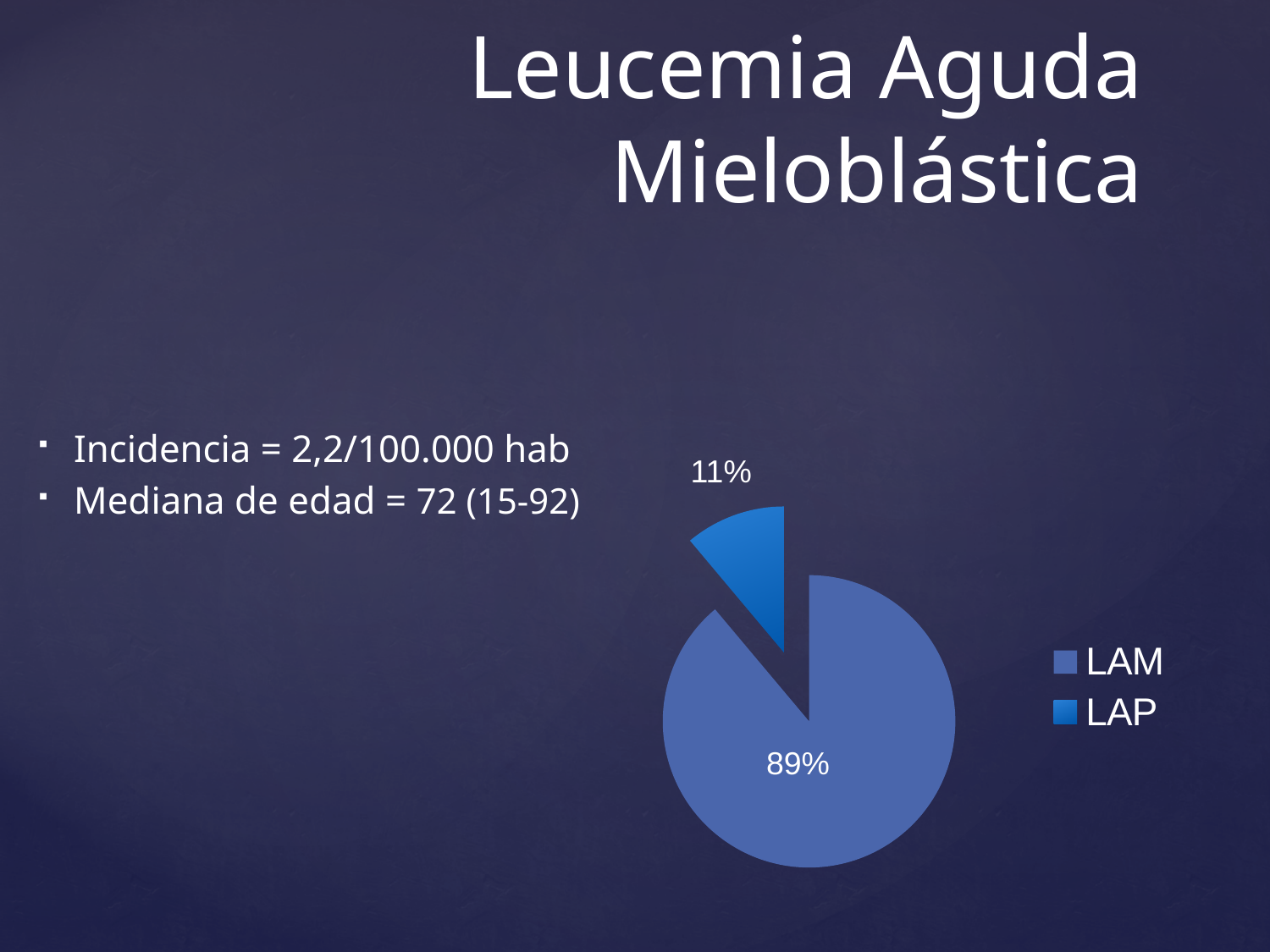
What is the difference in percentage points between the LAM and LAP slices? 78 Which is larger, the share for LAM or the share for LAP? LAM What are the two legend entries of the pie chart? LAM and LAP How many slices does the pie chart have? 2 Which category has the largest slice of the pie? LAM What kind of chart is shown on the slide? pie chart What share of the pie does LAP represent? 11% What share of the pie does LAM represent? 89% Which category has the smallest slice of the pie? LAP How many entries does the legend list? 2 Which slice is pulled out (exploded) from the pie? LAP